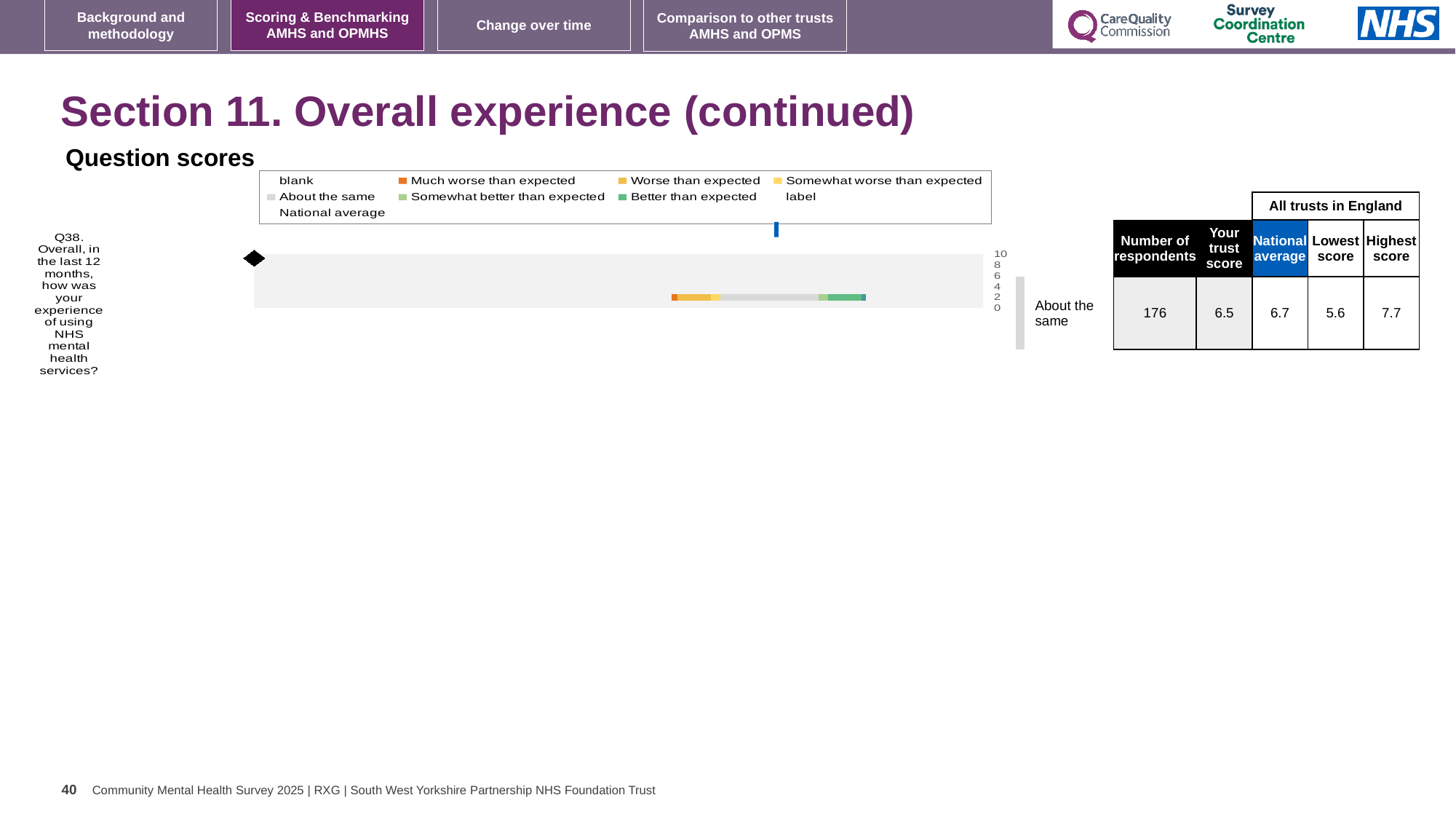
What benchmark category is shown for Q38 in the Question scores chart? About the same For Q38, which is larger: your trust score or the national average? National average What is the lowest score among all trusts in England for Q38? 5.6 For Q38, what is the difference between the highest score and the lowest score among all trusts in England? 2.1 How many survey questions are plotted in the Question scores chart? 1 What is the number of respondents for Q38? 176 What is the national average score for Q38? 6.7 Which legend entry is shown in orange in the Question scores chart? Much worse than expected What is 'Your trust score' for Q38? 6.5 What is the highest score among all trusts in England for Q38? 7.7 Which question is plotted in the Question scores chart? Q38. Overall, in the last 12 months, how was your experience of using NHS mental health services? What kind of chart is shown under 'Question scores'? bar chart